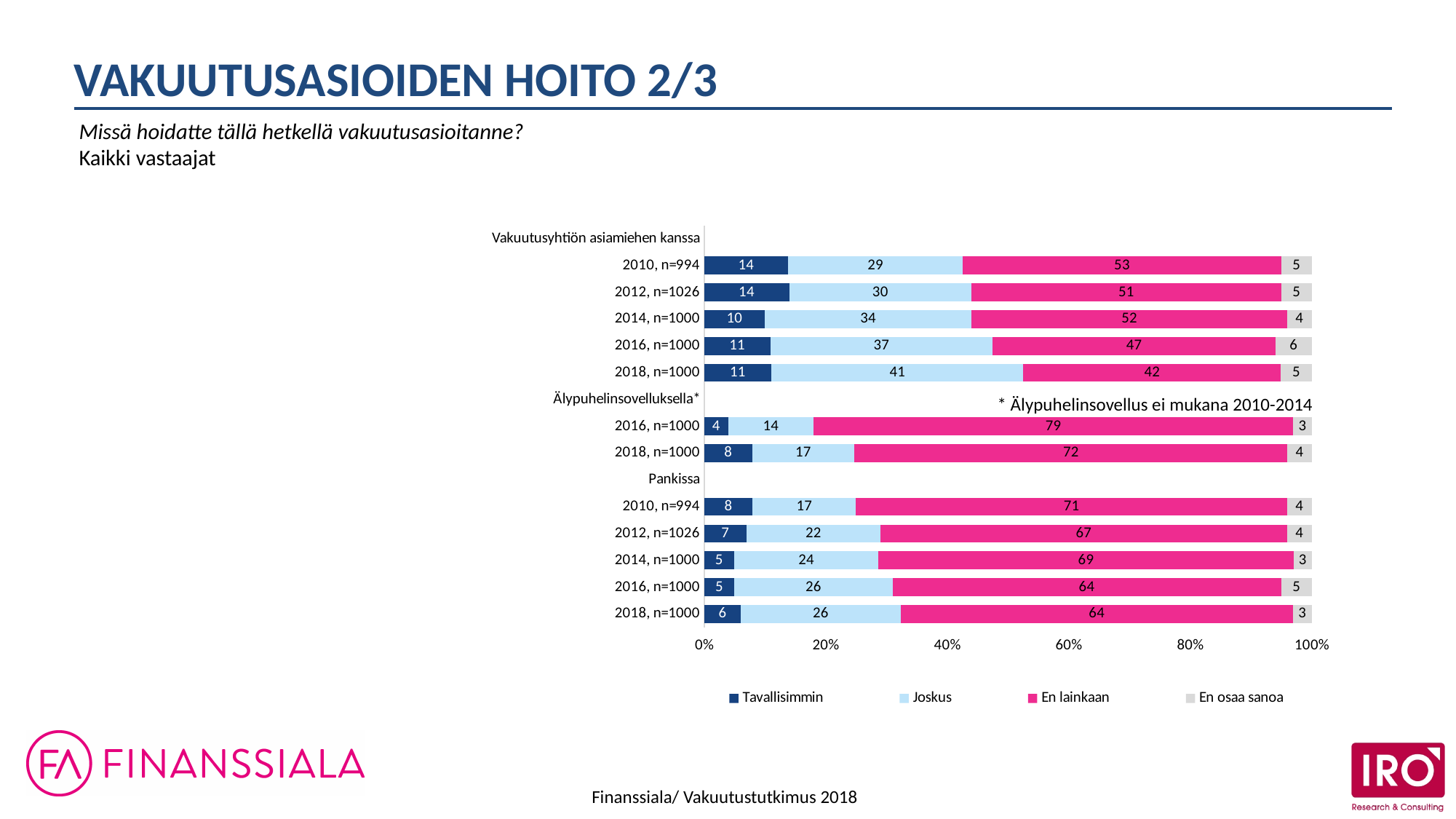
Which year has the highest 'En lainkaan' value in the 'Älypuhelinsovelluksella' group? 2016, n=1000 How many series does the legend list? 4 Does the 'Joskus' value for 'Vakuutusyhtiön asiamiehen kanssa' rise or fall from 2010 to 2018? Rise What is the 'Joskus' value for 'Vakuutusyhtiön asiamiehen kanssa' in 2018, n=1000? 41 How many year bars are shown in the 'Pankissa' group? 5 What is the 'En lainkaan' value for 'Vakuutusyhtiön asiamiehen kanssa' in 2010, n=994? 53 What is the 'En lainkaan' value for 'Pankissa' in 2012, n=1026? 67 What is the 'Tavallisimmin' value for 'Älypuhelinsovelluksella' in 2016, n=1000? 4 Which is larger: the 'En lainkaan' value for 'Pankissa' in 2010, n=994 or in 2018, n=1000? 2010, n=994 What kind of chart is shown on the slide? Stacked bar chart Which year has the lowest 'Tavallisimmin' value in the 'Vakuutusyhtiön asiamiehen kanssa' group? 2014, n=1000 What is the difference between the 'Joskus' values for 'Vakuutusyhtiön asiamiehen kanssa' in 2018, n=1000 and 2010, n=994? 12